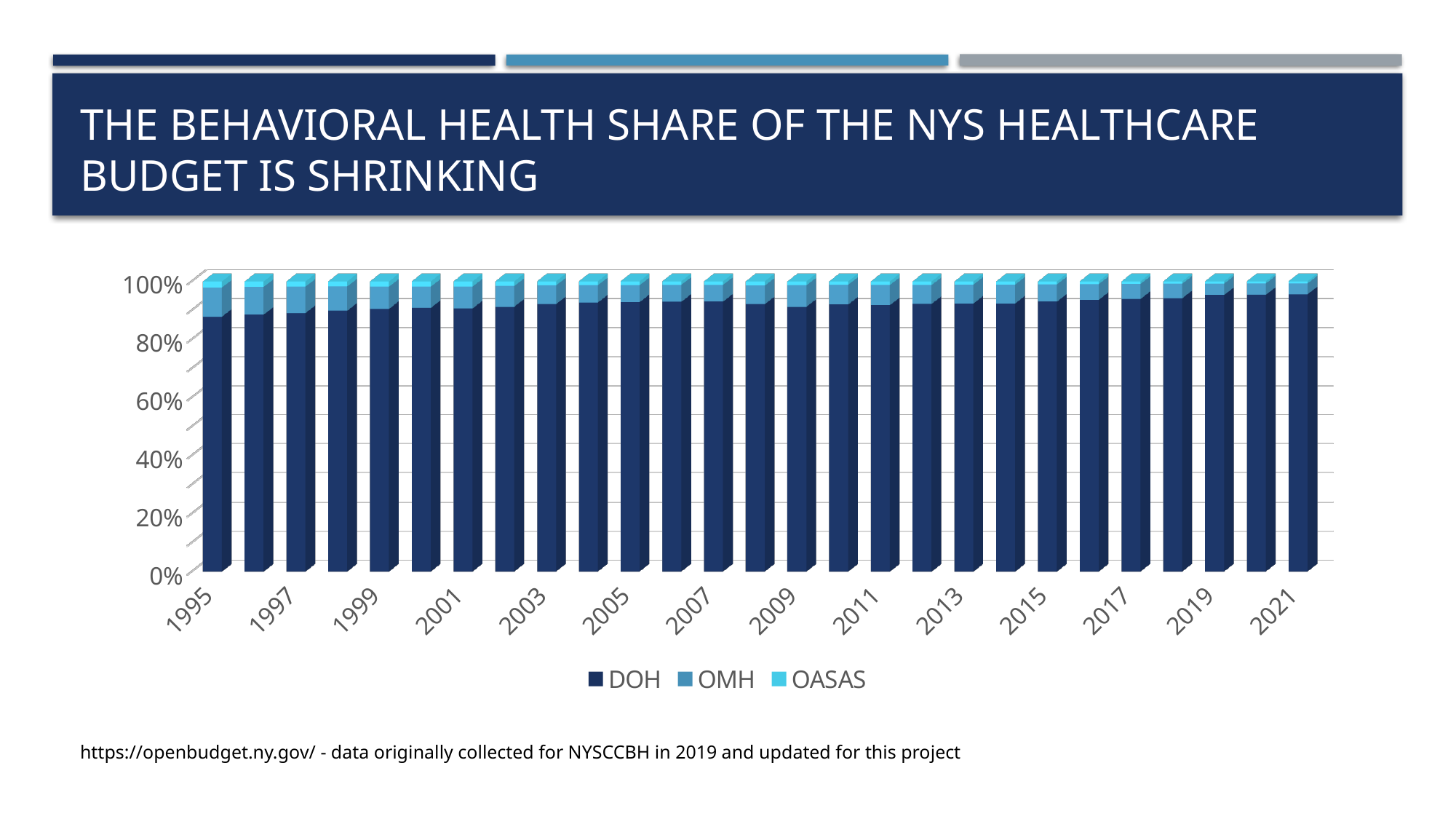
Does the DOH share of the budget rise or fall from 1995 to 2021? Rise What kind of chart is shown on the slide? Stacked bar chart What is the total height of each stacked bar on the chart? 100% How many years (bars) are plotted on the chart? 27 Which year has the larger DOH share, 1995 or 2021? 2021 What is the first year shown on the x axis? 1995 What is the title of the slide containing the chart? The Behavioral Health Share of the NYS Healthcare Budget Is Shrinking Is the DOH share for 1995 greater or less than 80%? greater Which series are listed in the legend? DOH, OMH, OASAS How many series does the legend list? 3 What is the last year shown on the x axis? 2021 Is the DOH share for 2021 greater or less than 80%? greater